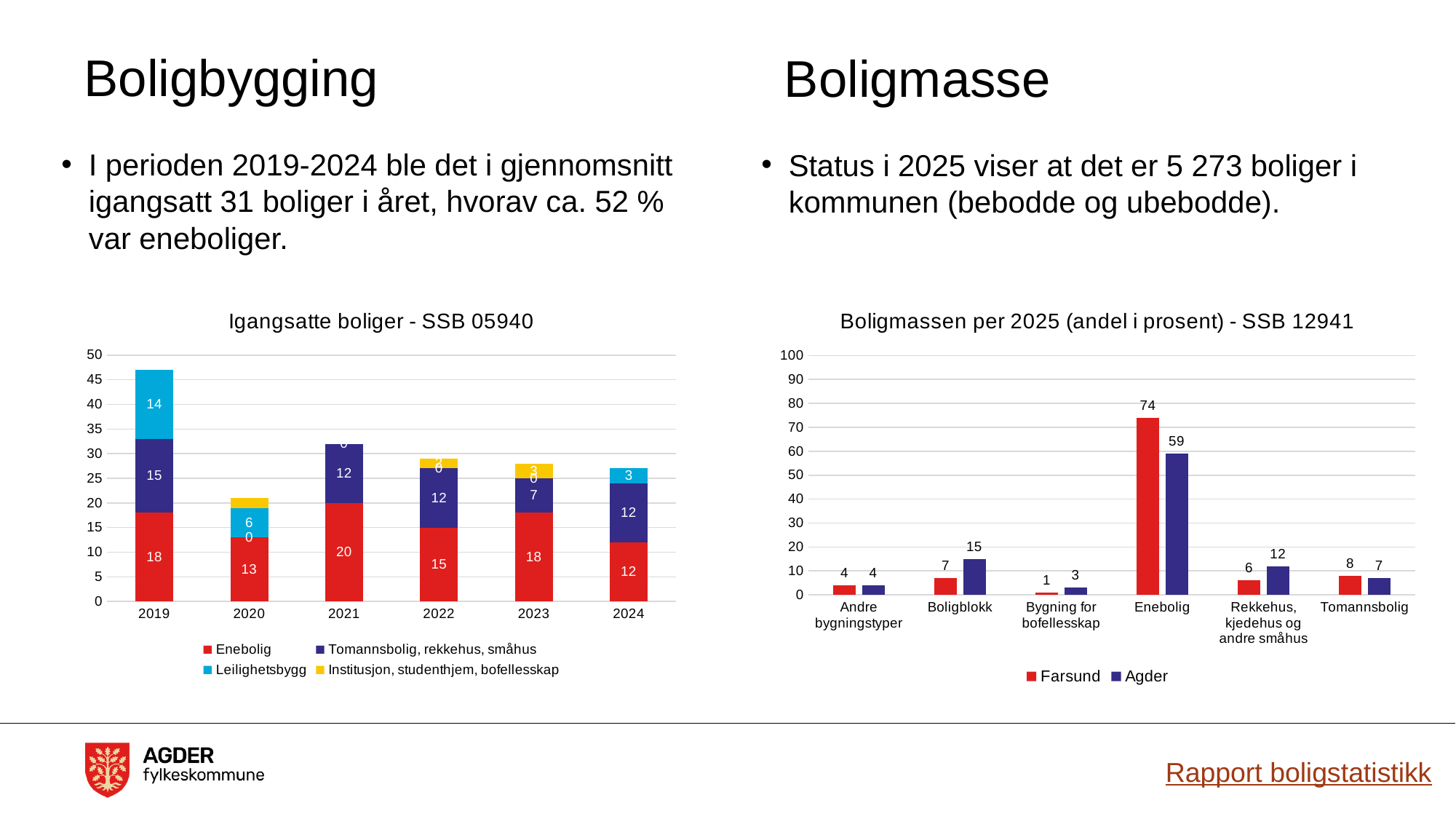
How many years are shown on the x axis of the chart 'Igangsatte boliger - SSB 05940'? 6 In the chart 'Boligmassen per 2025 (andel i prosent) - SSB 12941', which category has the highest value for Farsund? Enebolig In the chart 'Boligmassen per 2025 (andel i prosent) - SSB 12941', what is the value for Agder in the Boligblokk category? 15 In the chart 'Boligmassen per 2025 (andel i prosent) - SSB 12941', which category has the lowest value for Agder? Bygning for bofellesskap In the chart 'Boligmassen per 2025 (andel i prosent) - SSB 12941', which is larger for Tomannsbolig: Farsund or Agder? Farsund In the chart 'Boligmassen per 2025 (andel i prosent) - SSB 12941', what is the difference between Farsund and Agder in the Enebolig category? 15 How many series does the legend of the chart 'Boligmassen per 2025 (andel i prosent) - SSB 12941' list? 2 In the chart 'Igangsatte boliger - SSB 05940', what is the Leilighetsbygg value for 2019? 14 In the chart 'Igangsatte boliger - SSB 05940', what is the Enebolig value for 2021? 20 What kind of chart is 'Igangsatte boliger - SSB 05940'? Stacked bar chart In the chart 'Boligmassen per 2025 (andel i prosent) - SSB 12941', what is the value for Farsund in the Enebolig category? 74 In the chart 'Igangsatte boliger - SSB 05940', which year has the tallest stacked bar? 2019